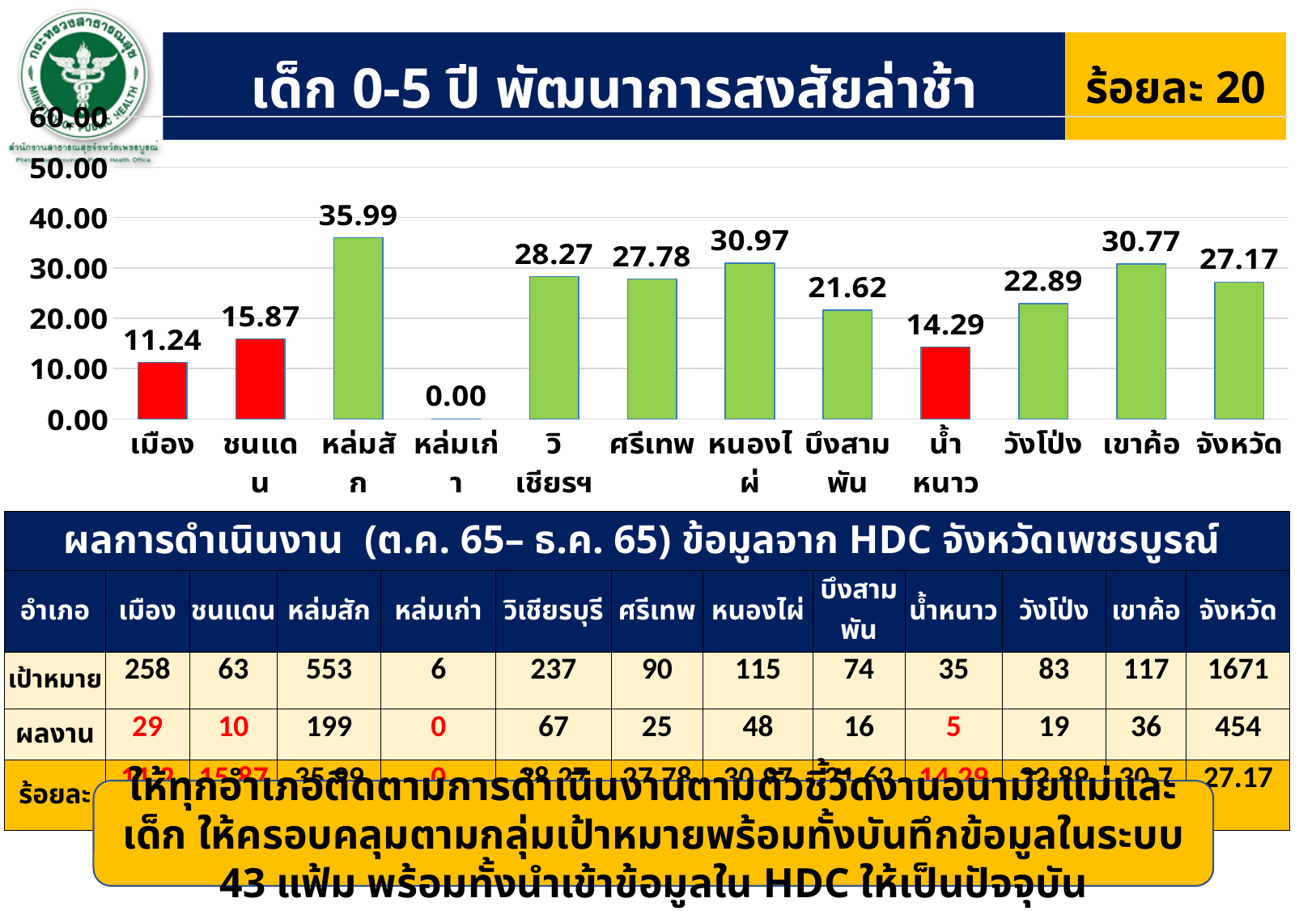
Is the value for บึงสามพัน greater or less than 20.00? greater Which category has the lowest value in the bar chart? หล่มเก่า What is the title of the chart? เด็ก 0-5 ปี พัฒนาการสงสัยล่าช้า What is the value for จังหวัด in the bar chart? 27.17 How many categories are shown on the x axis of the bar chart? 12 What colour are the bars for เมือง, ชนแดน and น้ำหนาว? red Which category has the highest value in the bar chart? หล่มสัก Which is larger, the value for เขาค้อ or the value for วังโป่ง? เขาค้อ What is the value for หล่มสัก in the bar chart? 35.99 What is the value for หนองไผ่ in the bar chart? 30.97 What is the difference between the values for หล่มสัก and เมือง? 24.75 What kind of chart is shown on the slide? bar chart